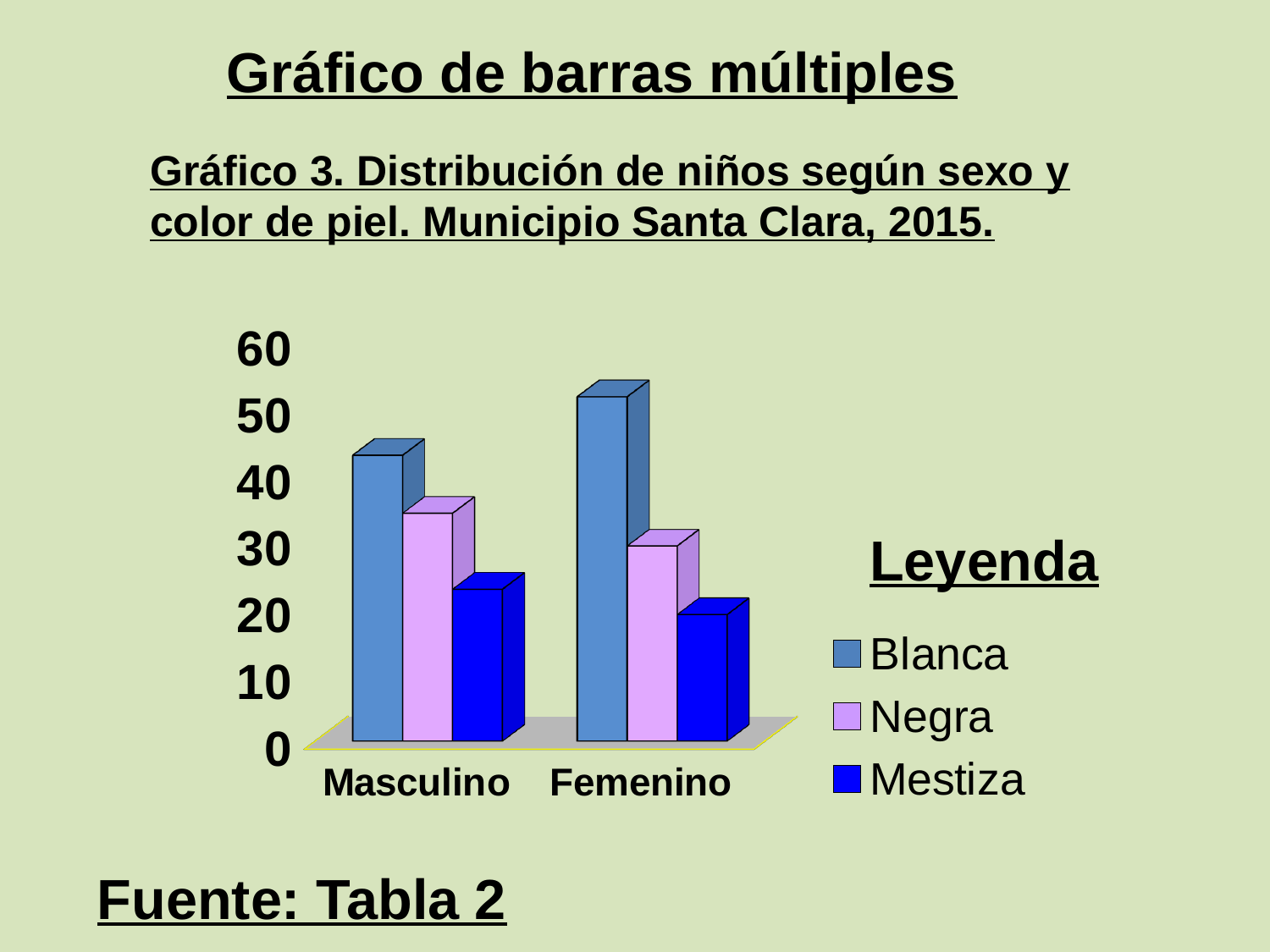
Which category has the tallest bar in the whole chart? Femenino What is the title of the legend on the slide? Leyenda Which series has the highest bar in the Femenino category? Blanca Which is larger, the Blanca value for Masculino or the Blanca value for Femenino? Femenino Is the Mestiza value for Femenino greater or less than 30? less How many categories are shown on the x axis? 2 What kind of chart is shown on the slide? bar chart How many series does the legend list? 3 Is the Blanca value for Masculino greater or less than 30? greater Which series has the lowest bar in the Masculino category? Mestiza Is the Negra value for Femenino greater or less than 40? less Which is larger, the Negra value for Masculino or the Negra value for Femenino? Masculino